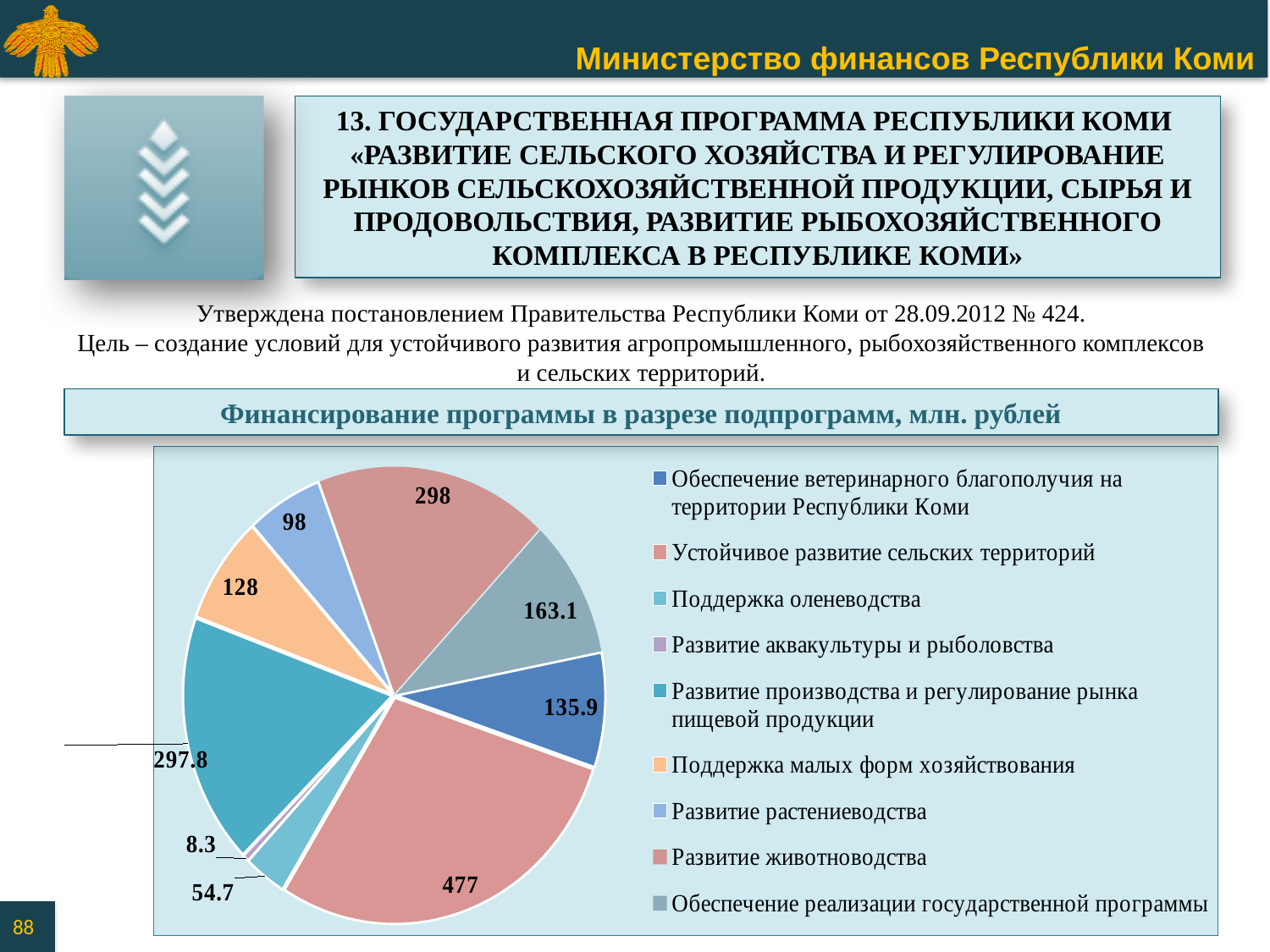
What is the value for «Обеспечение ветеринарного благополучия на территории Республики Коми»? 135.9 How many slices does the pie chart have? 9 Which subprogram has the smallest slice of the pie? Развитие аквакультуры и рыболовства How many entries does the chart legend list? 9 What is the title of the chart? Финансирование программы в разрезе подпрограмм, млн. рублей What is the difference between the values for «Устойчивое развитие сельских территорий» and «Обеспечение ветеринарного благополучия на территории Республики Коми»? 341.1 What is the value for «Устойчивое развитие сельских территорий»? 477 What kind of chart is shown on the slide? pie chart Which is larger: the value for «Поддержка малых форм хозяйствования» or the value for «Развитие растениеводства»? Поддержка малых форм хозяйствования What is the value for «Обеспечение реализации государственной программы»? 163.1 What is the value for «Развитие аквакультуры и рыболовства»? 8.3 Which subprogram has the largest slice of the pie? Устойчивое развитие сельских территорий